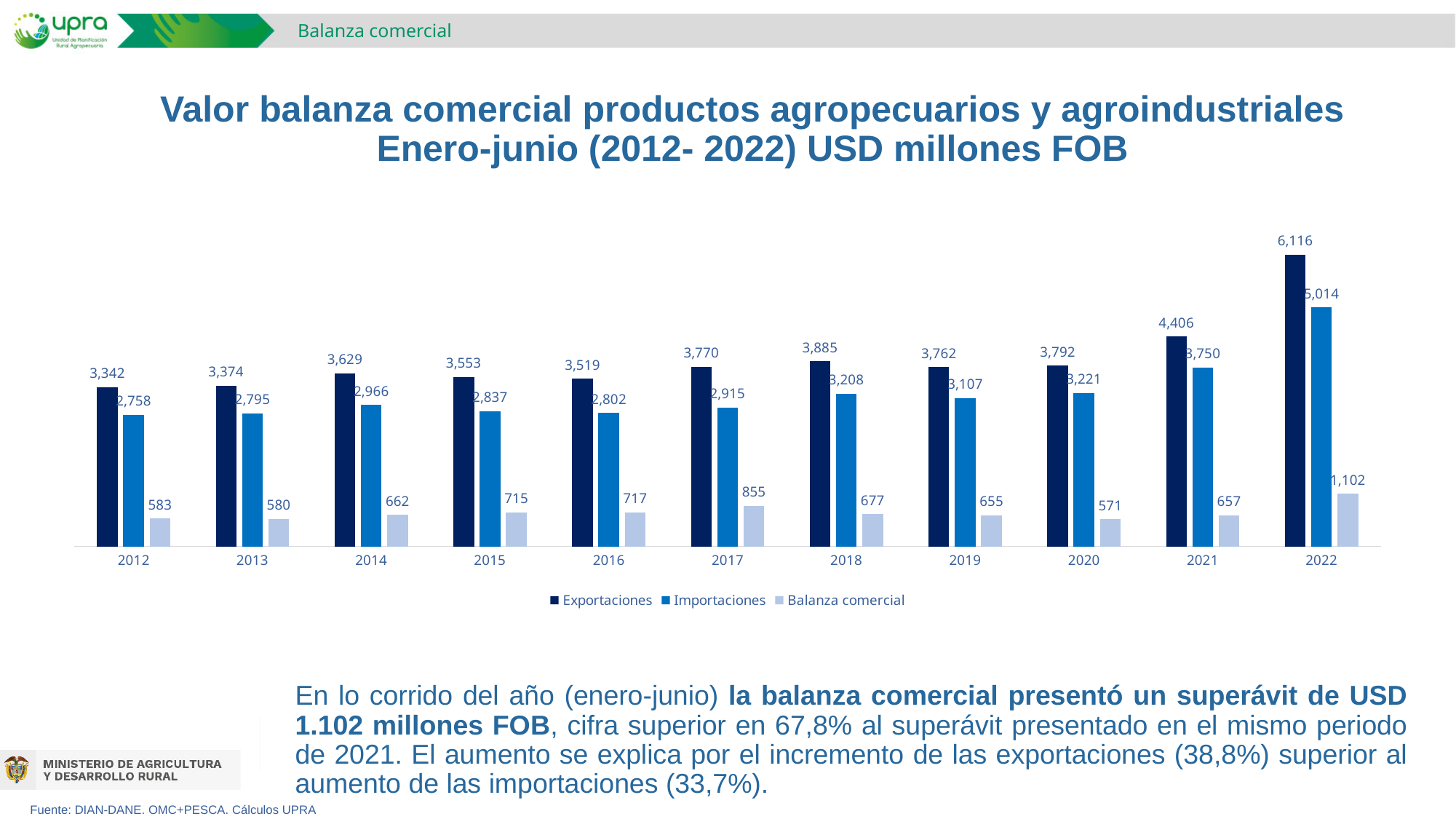
What is the value of Balanza comercial for 2017? 855 How many years are shown on the x axis? 11 In which year is Balanza comercial lowest? 2020 How many series does the legend list? 3 By how much did Balanza comercial increase from 2021 to 2022? 445 In which year is Exportaciones highest? 2022 What kind of chart is shown on the slide? Bar chart What is the value of Importaciones for 2015? 2,837 What is the value of Exportaciones for 2018? 3,885 Do the Exportaciones values rise or fall from 2019 to 2022? Rise Which is larger, Balanza comercial in 2017 or in 2018? 2017 What is the difference between Exportaciones and Importaciones in 2022? 1,102